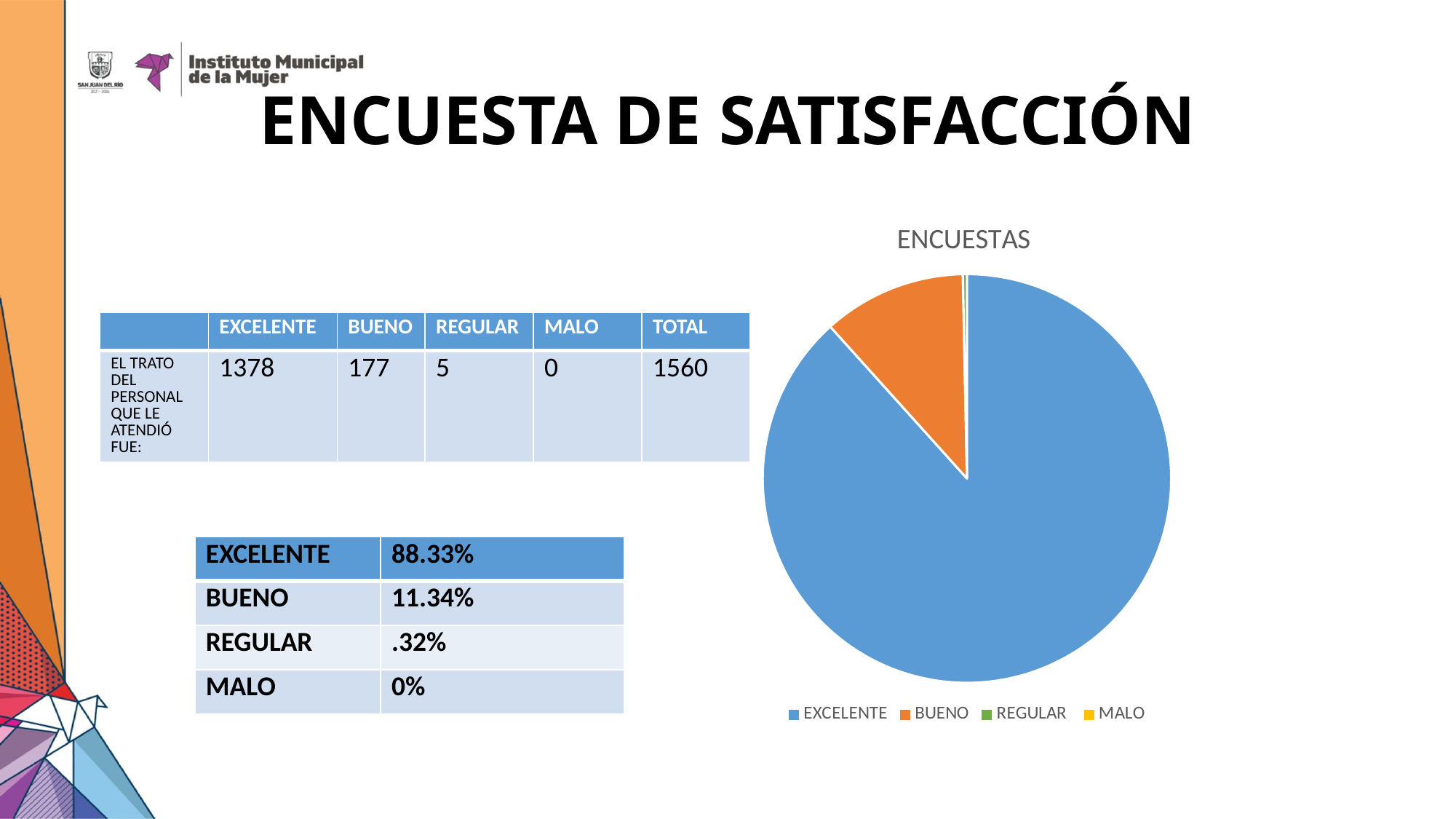
What colour is the BUENO slice in the pie chart? orange Which category has the smallest value in the pie chart? MALO Which slice is larger in the pie chart, BUENO or REGULAR? BUENO What share of the pie does EXCELENTE represent, according to the slide? 88.33% What share of the pie does BUENO represent, according to the slide? 11.34% What is the value for EXCELENTE shown on the slide? 1378 Which category takes the largest slice of the pie chart? EXCELENTE What is the difference between the EXCELENTE and BUENO values shown on the slide? 1201 What kind of chart is shown on the slide? pie chart What is the value for REGULAR shown on the slide? 5 What is the title of the pie chart? ENCUESTAS How many entries does the legend of the pie chart list? 4